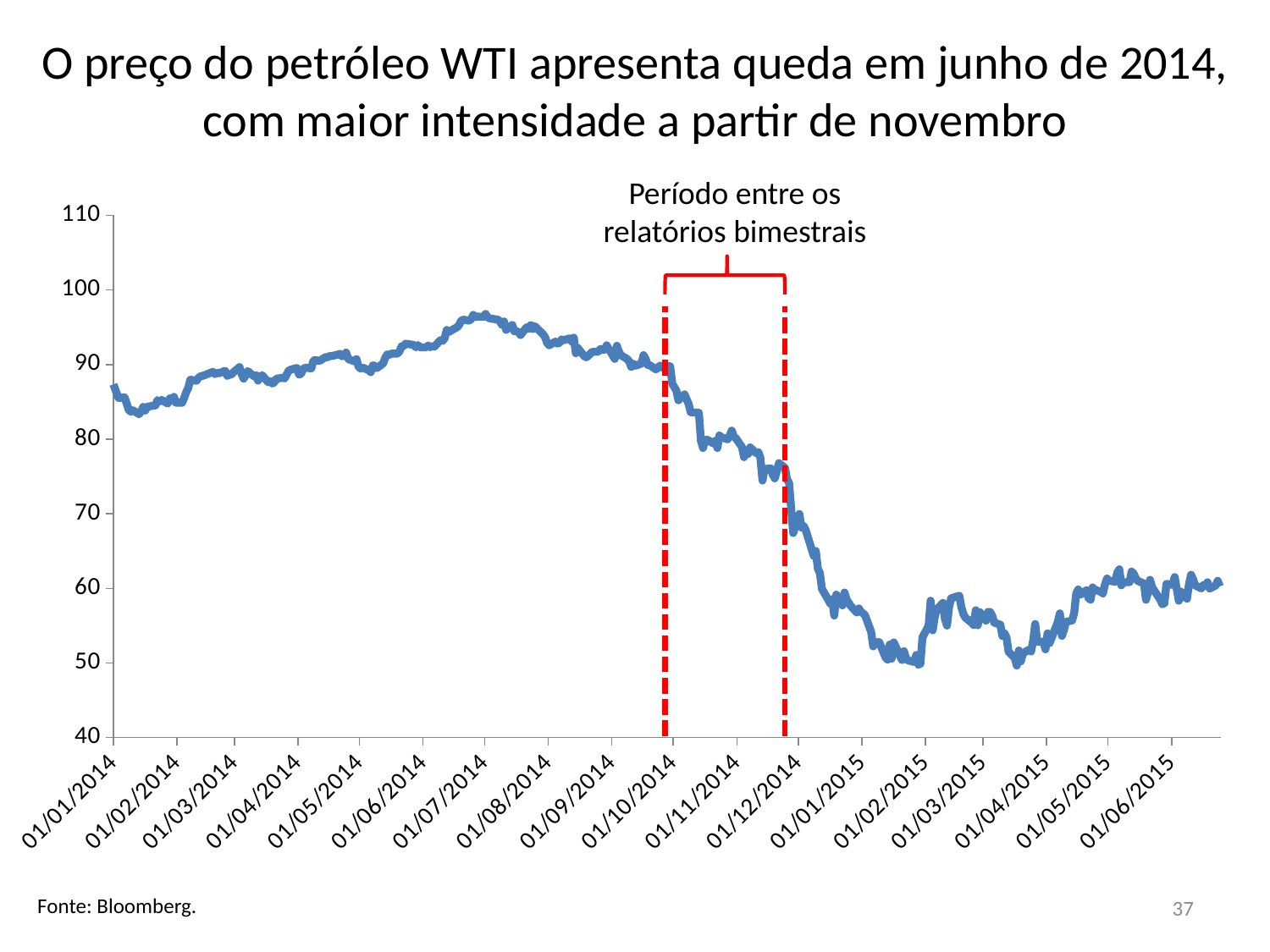
Is the WTI price on 01/07/2014 greater or less than 90? greater Does the WTI price rise or fall between 01/10/2014 and 01/01/2015? fall How many date labels are shown on the x axis? 18 What is the source cited for the chart? Bloomberg Is the WTI price on 01/01/2015 greater or less than 60? less Is the WTI price on 01/02/2015 greater or less than 60? less Does the WTI price rise or fall between 01/04/2015 and 01/06/2015? rise What does the red dashed bracket on the chart mark? Período entre os relatórios bimestrais Which is higher, the WTI price on 01/07/2014 or on 01/01/2015? 01/07/2014 What kind of chart is shown on the slide? line chart